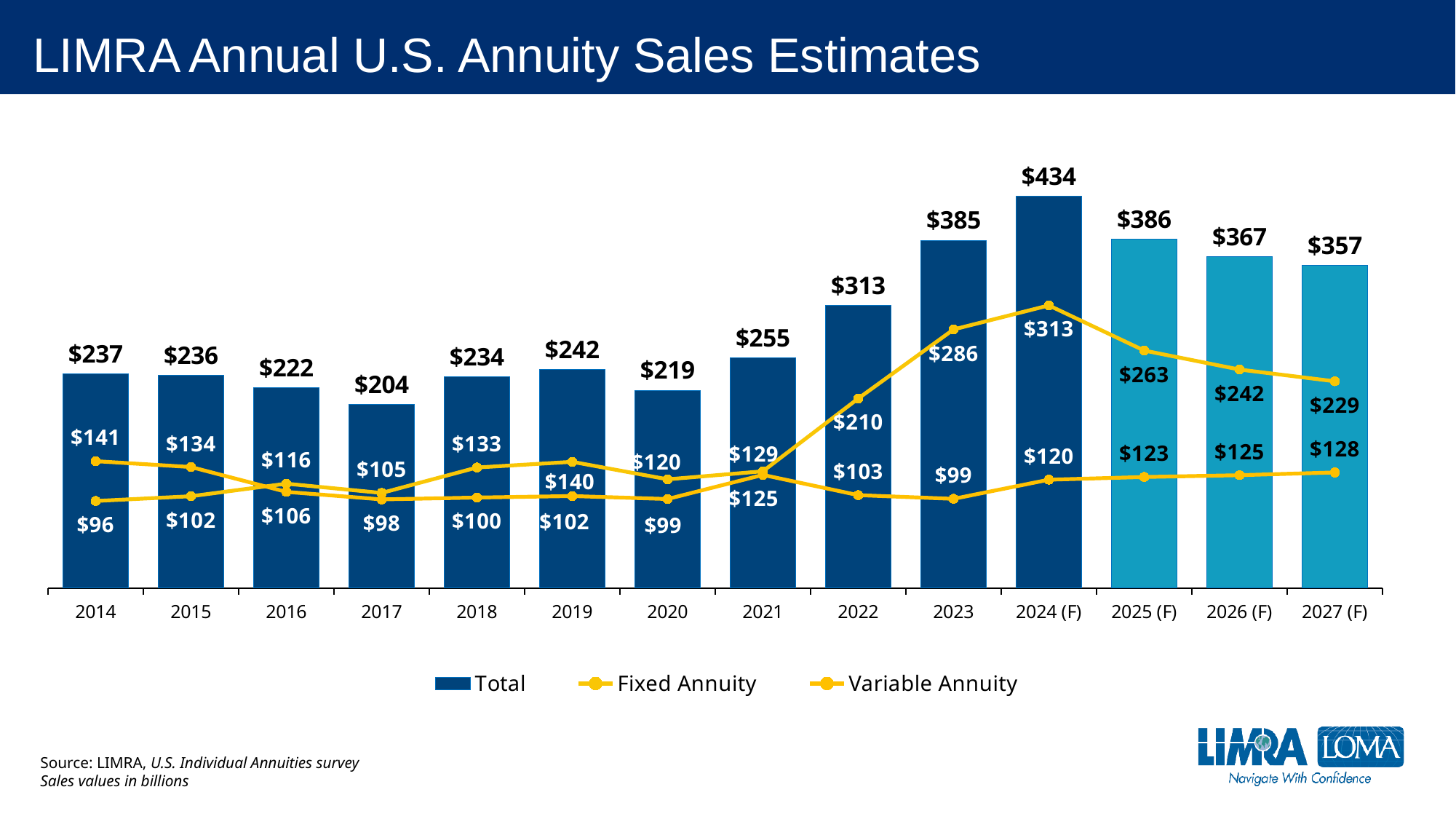
What is the Total annuity sales value shown for 2024 (F)? $434 How many series does the legend list? 3 What is the difference between the Total for 2024 (F) and the Total for 2023? $49 What kind of chart is used for the Total series? Bar chart Which year has the lowest Total annuity sales? 2017 Does the Total rise or fall from 2021 to 2024 (F)? Rise Which year has the highest Total annuity sales? 2024 (F) What is the Total annuity sales value shown for 2027 (F)? $357 What is the Total annuity sales value shown for 2014? $237 Which year has the larger Total, 2018 or 2019? 2019 How many years are shown on the x axis? 14 What is the difference between the Total for 2025 (F) and the Total for 2027 (F)? $29